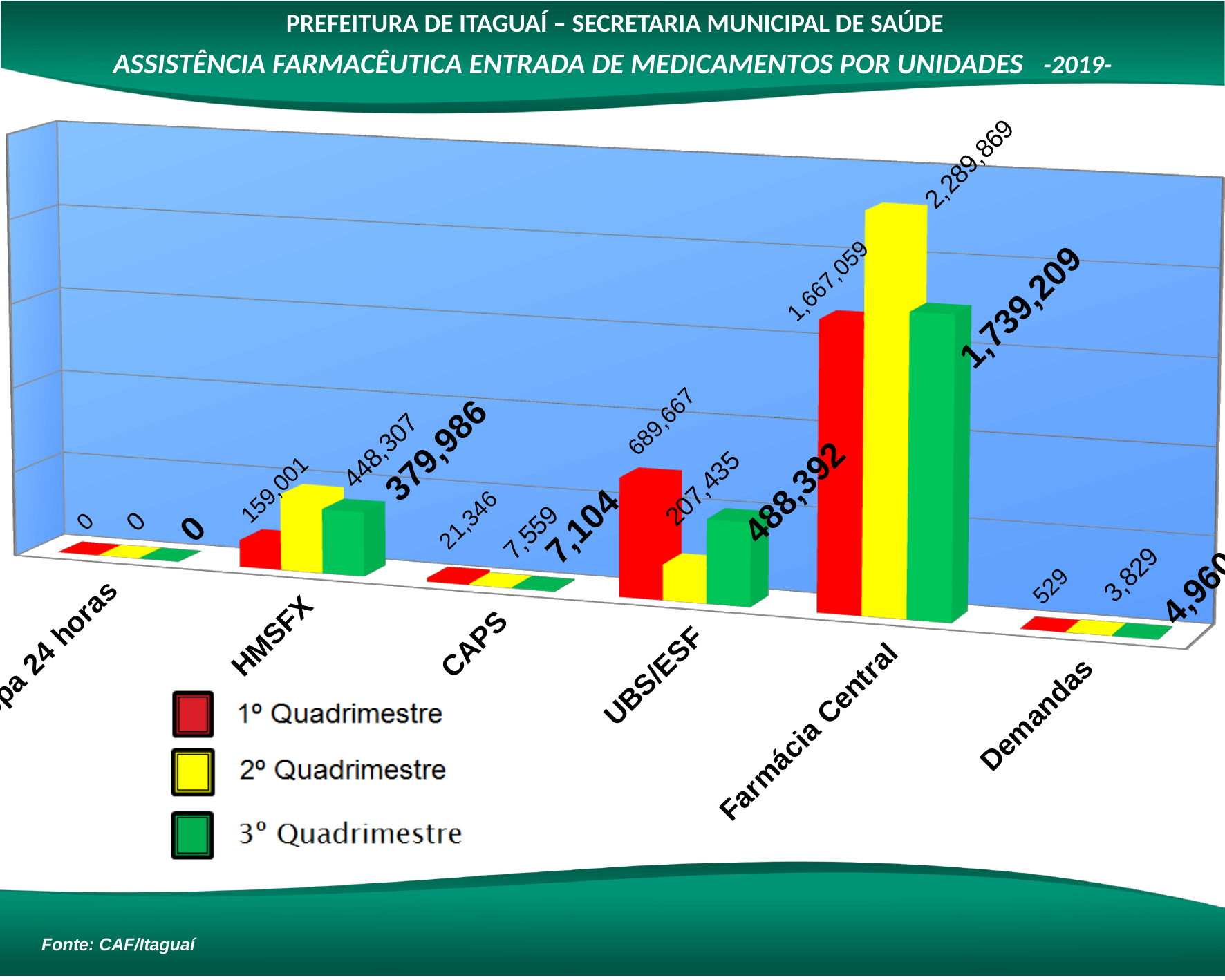
Which category has the highest value in the 2º Quadrimestre series? Farmácia Central What is the value for Farmácia Central in the 1º Quadrimestre series? 1,667,059 What is the difference between the 1º Quadrimestre and 2º Quadrimestre values for CAPS? 13,787 What is the value for HMSFX in the 2º Quadrimestre series? 448,307 Which series has the highest value for UBS/ESF? 1º Quadrimestre What is the value for Demandas in the 3º Quadrimestre series? 4,960 Which is larger: the 3º Quadrimestre value for HMSFX or for UBS/ESF? UBS/ESF What is the difference between the 2º Quadrimestre and 1º Quadrimestre values for Farmácia Central? 622,810 How many categories are shown on the x axis? 6 What kind of chart is shown on the slide? Bar chart How many series does the legend list? 3 What is the value for CAPS in the 3º Quadrimestre series? 7,104